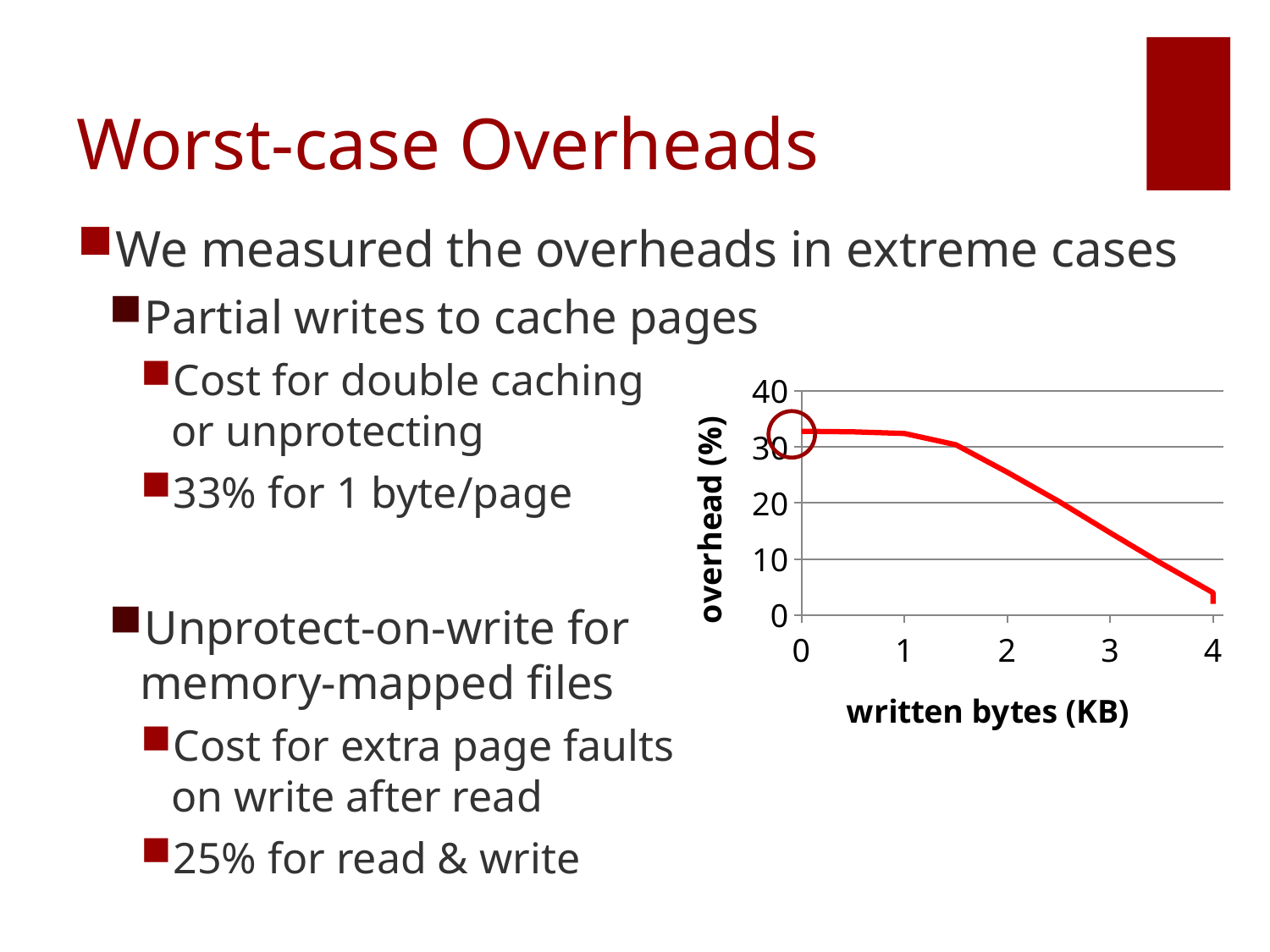
Is the overhead at 4 KB written bytes greater or less than 10? less Does the overhead rise or fall as written bytes increase from 1 KB to 4 KB? fall What is the highest value shown on the y axis of the chart? 40 Which is larger, the overhead at 1 KB or the overhead at 3 KB written bytes? 1 KB Is the overhead at 2 KB written bytes greater or less than 20? greater What kind of chart is shown on the slide? line chart Is the overhead at 0 KB written bytes greater or less than 30? greater What is the label of the x axis of the chart? written bytes (KB) At which written bytes value on the x axis is the overhead lowest? 4 What is the label of the y axis of the chart? overhead (%)